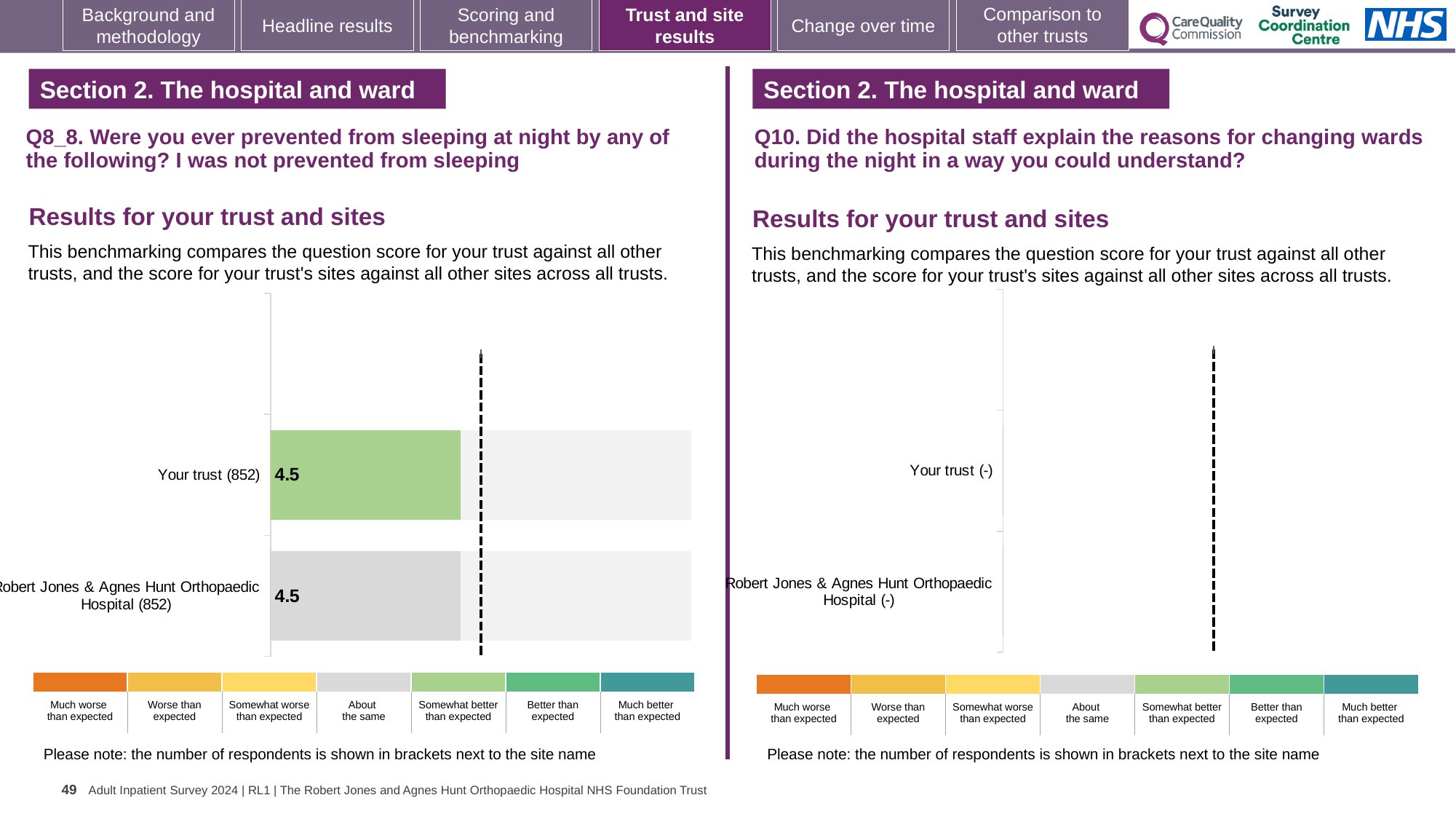
On the right chart (Q10), how many bars with plotted values are shown? 0 On the left chart (Q8_8), how many bars are plotted? 2 On the left chart (Q8_8), what is the score for Your trust? 4.5 On the left chart (Q8_8), what is the difference between the score for Your trust and the score for Robert Jones & Agnes Hunt Orthopaedic Hospital? 0 On the left chart (Q8_8), how many respondents are shown in brackets next to Your trust? 852 On the left chart (Q8_8), what is the score for Robert Jones & Agnes Hunt Orthopaedic Hospital? 4.5 On the left chart (Q8_8), which benchmark category does the grey colour of the Robert Jones & Agnes Hunt Orthopaedic Hospital bar correspond to in the legend? About the same On the left chart (Q8_8), how many respondents are shown in brackets next to Robert Jones & Agnes Hunt Orthopaedic Hospital? 852 On the right chart (Q10), what is shown in brackets next to Your trust? - How many benchmark categories does the colour legend below each chart list? 7 On the left chart (Q8_8), which benchmark category does the green colour of the Your trust bar correspond to in the legend? Somewhat better than expected What kind of chart is shown on the left side of the slide (Q8_8)? Bar chart